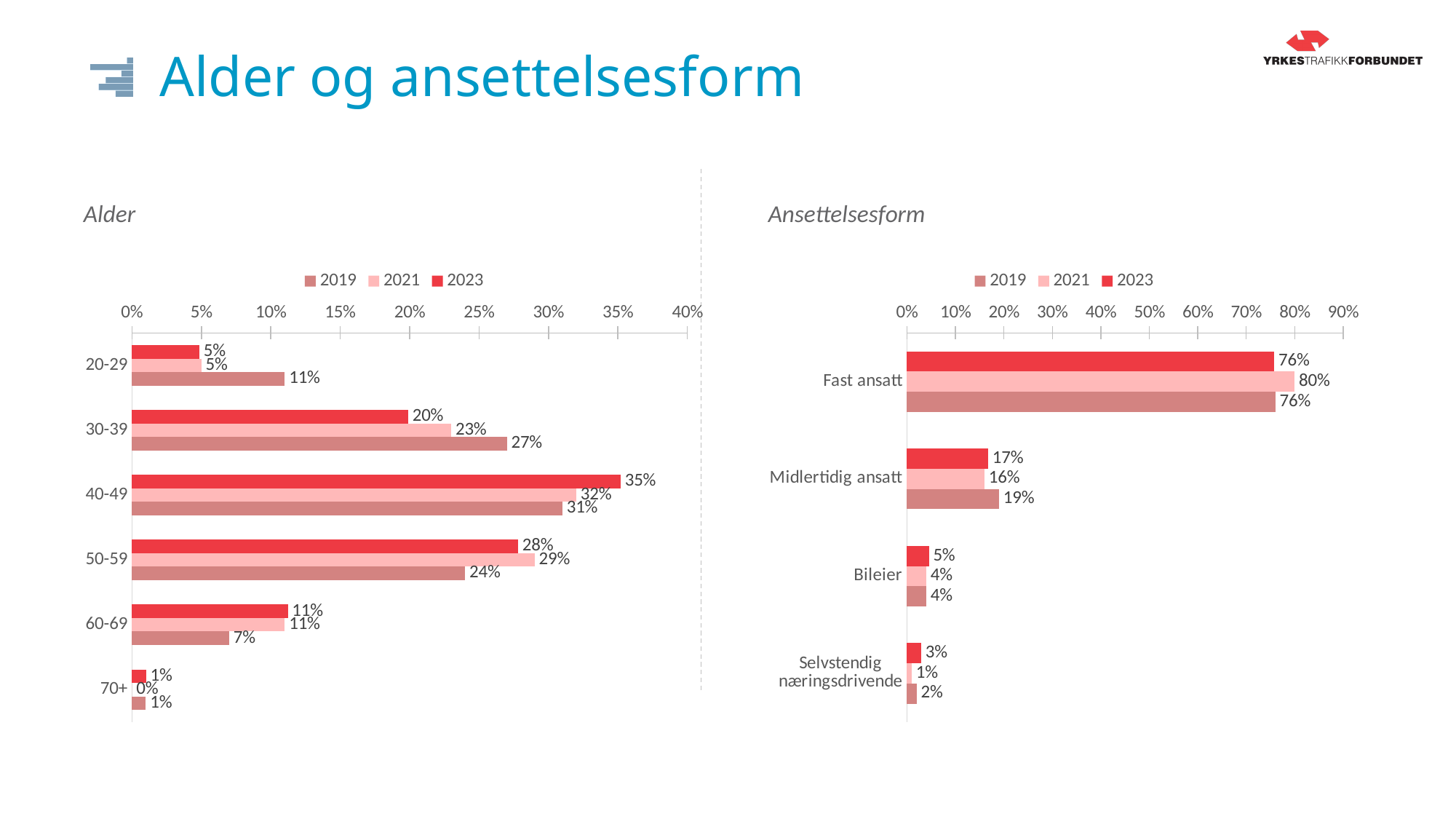
In the Ansettelsesform chart, how many series does the legend list? 3 What kind of chart is the Ansettelsesform chart? Bar chart In the Alder chart, what is the difference between the 2019 and 2023 values for 30-39? 7% In the Alder chart, which age group has the lowest value in 2021? 70+ In the Alder chart, what is the value for 40-49 in 2023? 35% In the Ansettelsesform chart, what is the difference between the 2021 and 2023 values for Selvstendig næringsdrivende? 2% In the Alder chart, which age group has the highest value in 2023? 40-49 In the Alder chart, how many age groups are shown? 6 In the Ansettelsesform chart, what is the value for Fast ansatt in 2021? 80% In the Ansettelsesform chart, which is larger for Bileier: the 2023 value or the 2019 value? 2023 In the Ansettelsesform chart, what is the value for Midlertidig ansatt in 2019? 19% In the Alder chart, what is the value for 20-29 in 2019? 11%